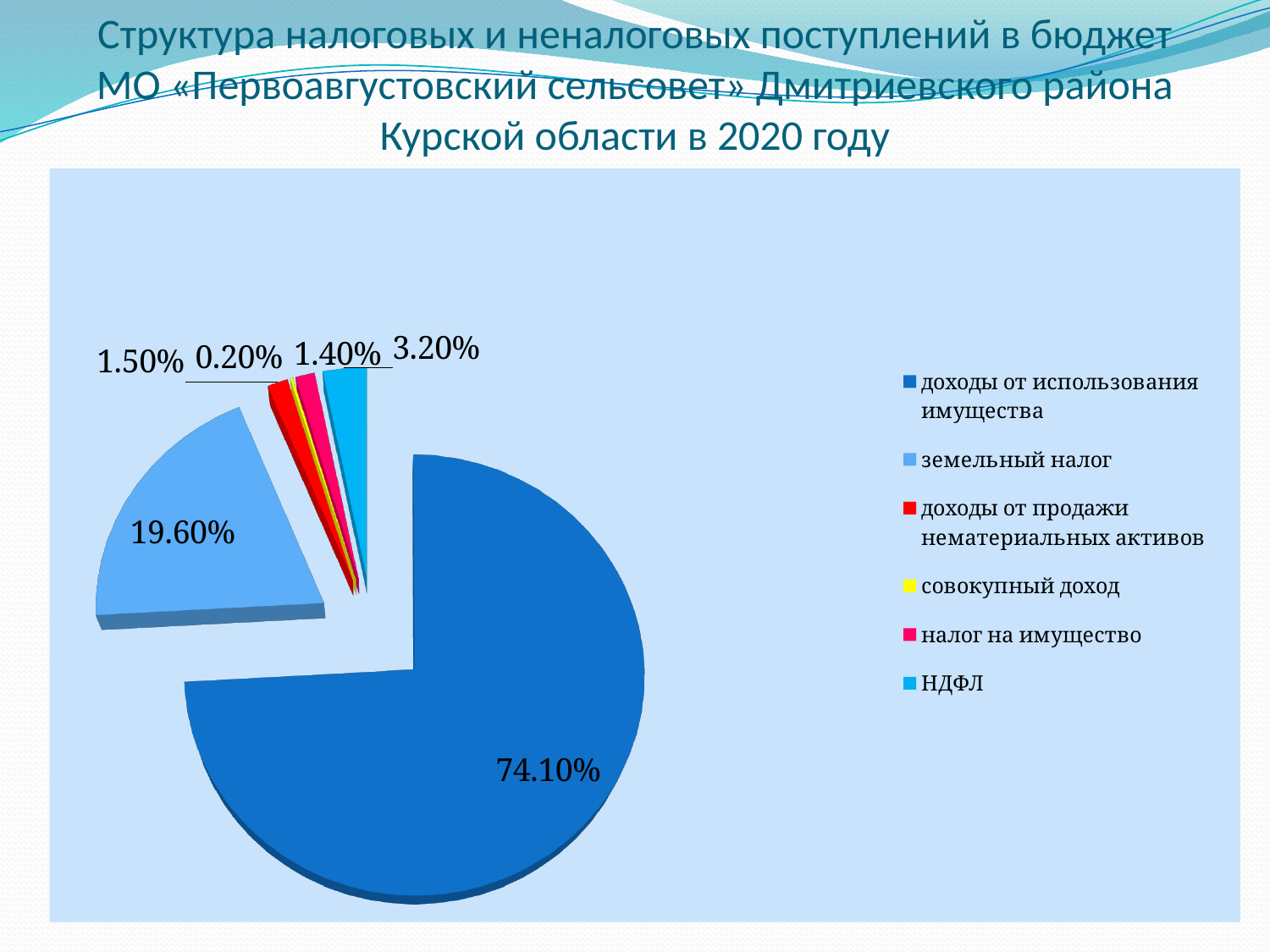
How many categories does the legend list? 6 What type of chart is shown on the slide? pie chart Which is larger: the share of "НДФЛ" or the share of "налог на имущество"? НДФЛ Which category has the smallest share of the pie? совокупный доход What share of the pie does "совокупный доход" have? 0.20% What is the difference between the shares of "доходы от использования имущества" and "земельный налог"? 54.50% What share of the pie does "земельный налог" have? 19.60% Which category has the largest share of the pie? доходы от использования имущества What share of the pie does "доходы от продажи нематериальных активов" have? 1.50% What share of the pie does "налог на имущество" have? 1.40% What share of the pie does "доходы от использования имущества" have? 74.10% What share of the pie does "НДФЛ" have? 3.20%